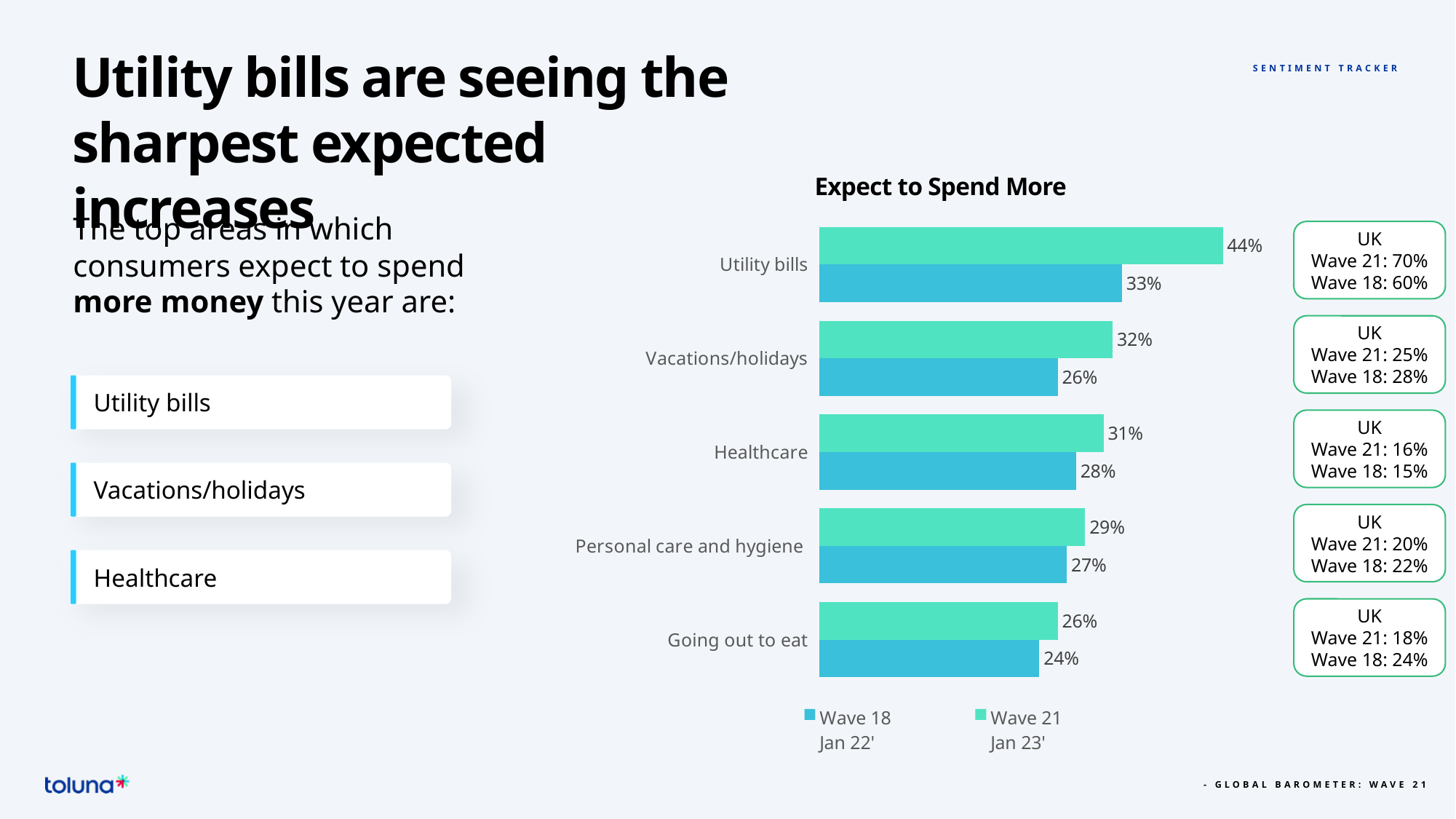
What is the Wave 21 value for Utility bills in the Expect to Spend More chart? 44% What is the Wave 18 value for Healthcare in the Expect to Spend More chart? 28% What is the difference between the Wave 21 and Wave 18 values for Utility bills in the Expect to Spend More chart? 11% What is the Wave 21 value for Going out to eat in the Expect to Spend More chart? 26% In the Expect to Spend More chart, is the Wave 21 value for Healthcare larger or smaller than the Wave 21 value for Personal care and hygiene? larger What is the difference between the Wave 21 and Wave 18 values for Vacations/holidays in the Expect to Spend More chart? 6% Which series in the Expect to Spend More chart is shown in green? Wave 21 Jan 23' How many series does the legend of the Expect to Spend More chart list? 2 How many categories are shown in the Expect to Spend More chart? 5 Which category has the lowest Wave 18 value in the Expect to Spend More chart? Going out to eat Which category has the highest Wave 21 value in the Expect to Spend More chart? Utility bills What type of chart is the Expect to Spend More chart? bar chart